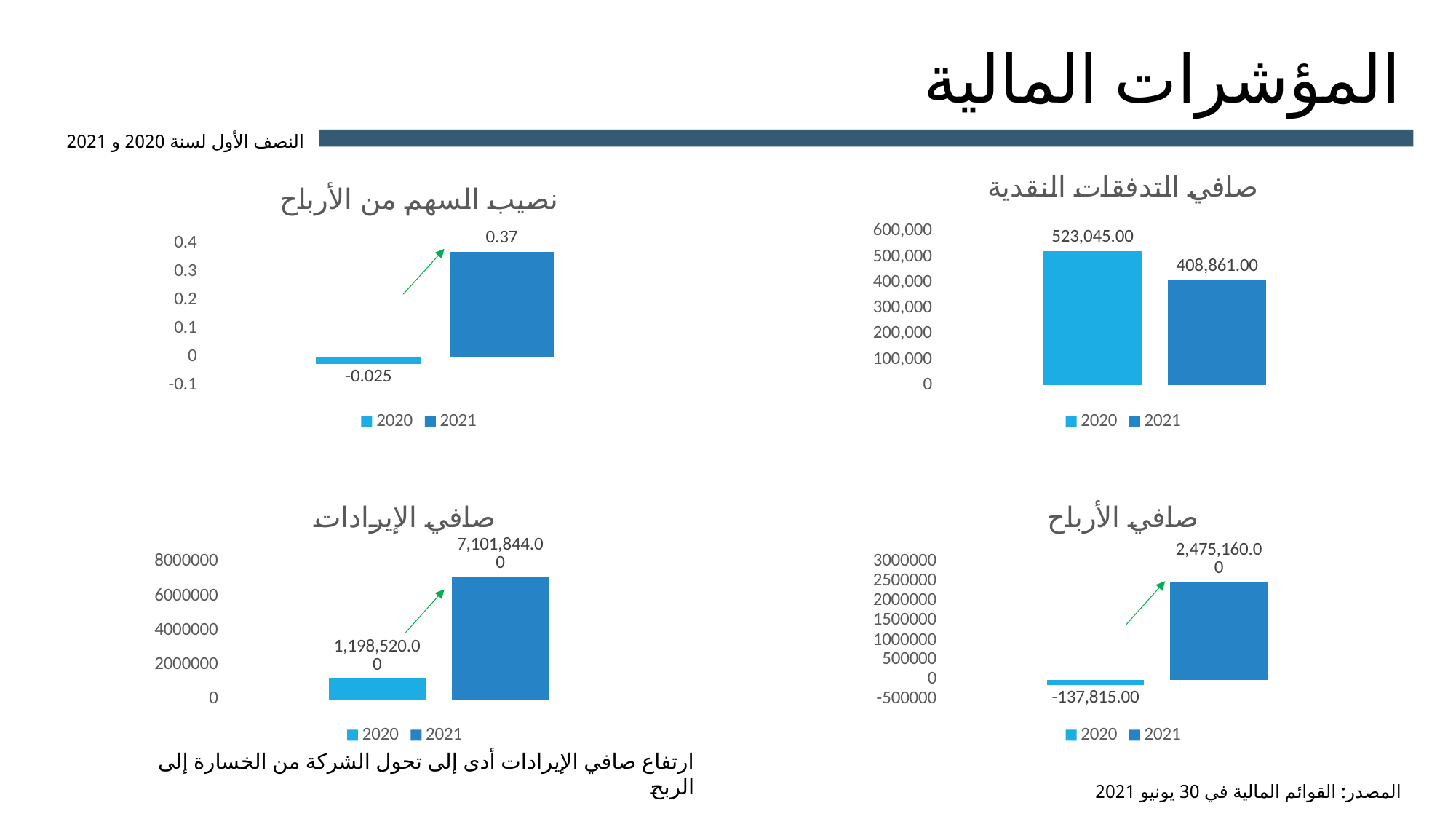
In the top-right chart titled "صافي التدفقات النقدية", which year has the higher value? 2020 In the top-right chart titled "صافي التدفقات النقدية", what is the value for 2021? 408,861.00 In the top-left chart titled "نصيب السهم من الأرباح", what is the value for 2020? -0.025 How many series does the legend of the bottom-right chart titled "صافي الأرباح" list? 2 In the top-left chart titled "نصيب السهم من الأرباح", what is the value for 2021? 0.37 In the bottom-left chart titled "صافي الإيرادات", what is the value for 2021? 7,101,844.00 In the bottom-left chart titled "صافي الإيرادات", what is the value for 2020? 1,198,520.00 In the bottom-right chart titled "صافي الأرباح", what is the value for 2020? -137,815.00 In the bottom-left chart titled "صافي الإيرادات", what is the difference between the 2021 and 2020 values? 5,903,324.00 In the top-right chart titled "صافي التدفقات النقدية", what is the value for 2020? 523,045.00 In the top-right chart titled "صافي التدفقات النقدية", what is the difference between the 2020 and 2021 values? 114,184.00 In the bottom-right chart titled "صافي الأرباح", what is the value for 2021? 2,475,160.00